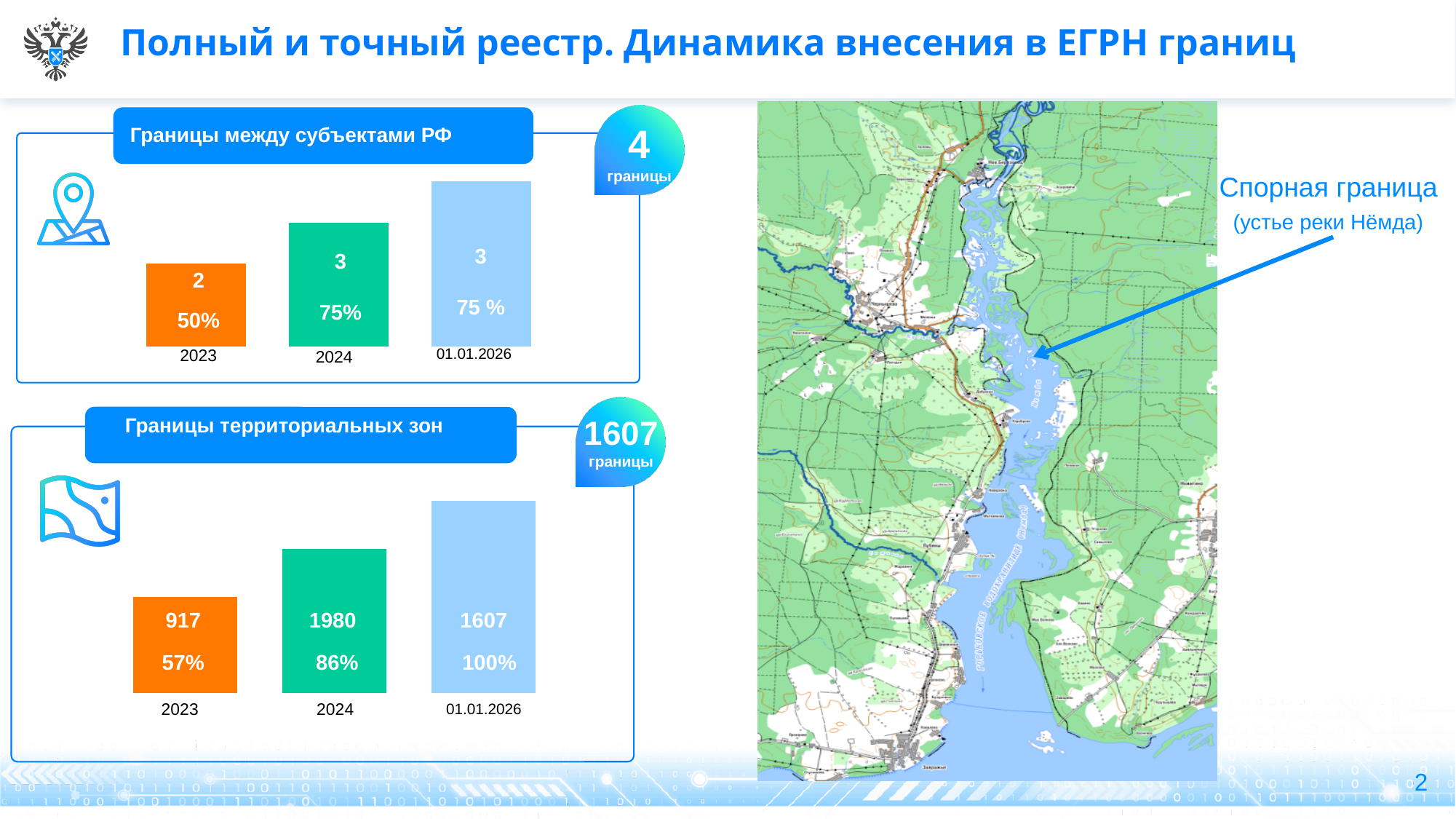
In the chart 'Границы между субъектами РФ', what percentage is shown for 01.01.2026? 75 % In the chart 'Границы территориальных зон', what value is shown for 2024? 1980 In the chart 'Границы территориальных зон', which year has the lowest percentage? 2023 What kind of chart is 'Границы между субъектами РФ'? bar chart What total number of boundaries is shown in the circle next to the chart 'Границы территориальных зон'? 1607 In the chart 'Границы территориальных зон', what percentage is shown for 01.01.2026? 100% How many bars are in the chart 'Границы территориальных зон'? 3 In the chart 'Границы территориальных зон', what is the difference between the values for 2024 and 2023? 1063 In the chart 'Границы между субъектами РФ', which is larger, the value for 2023 or the value for 2024? 2024 In the chart 'Границы между субъектами РФ', what percentage is shown for 2024? 75% In the chart 'Границы между субъектами РФ', what value is shown for 2023? 2 In the chart 'Границы территориальных зон', what value is shown for 2023? 917